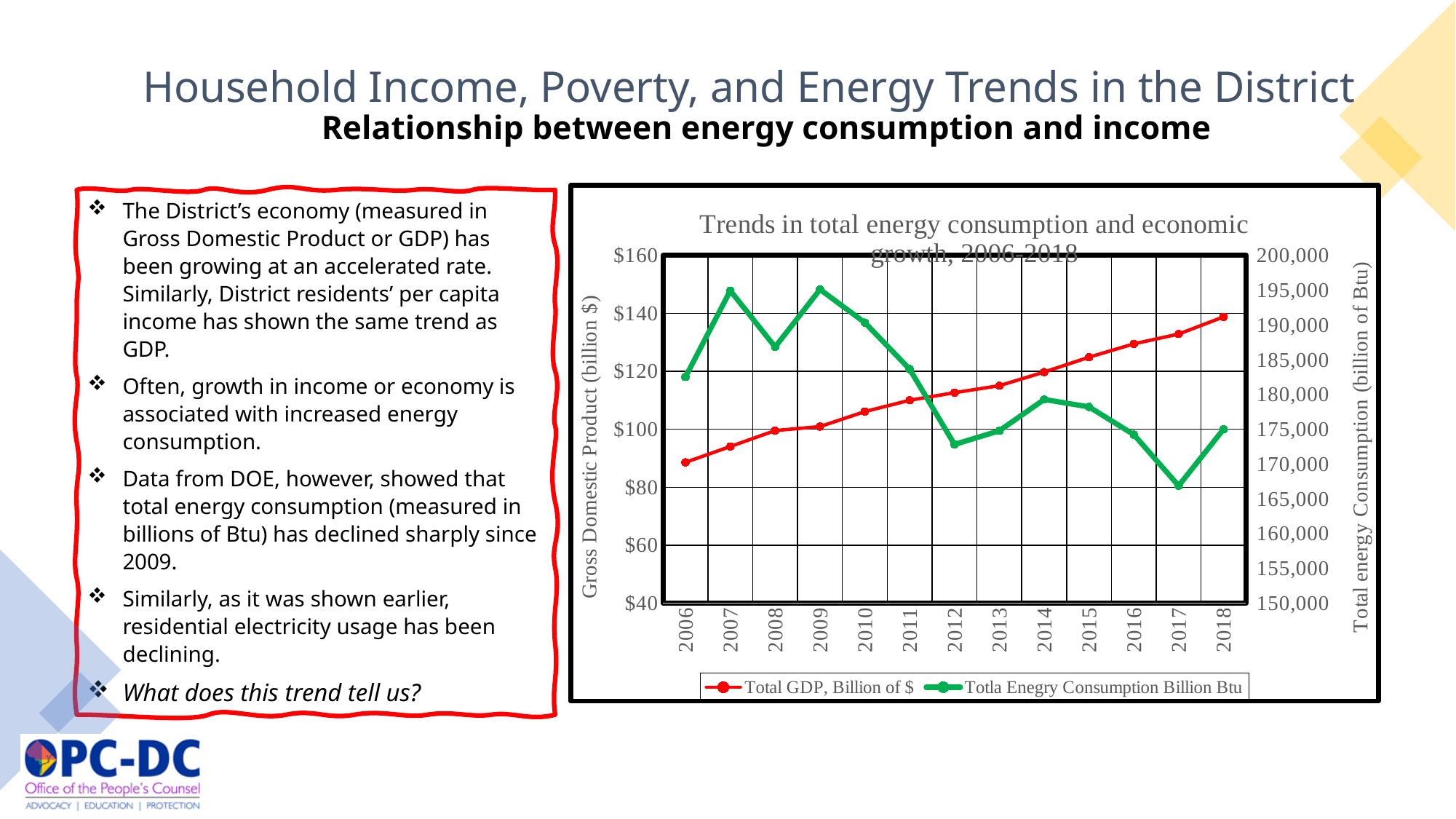
In which year is Total GDP highest? 2018 Does the Total GDP series rise or fall from 2006 to 2018? Rises In which year is Total GDP lowest? 2006 What is the label of the right-hand vertical axis of the chart? Total energy Consumption (billion of Btu) In which year is Total Energy Consumption lowest? 2017 How many series does the chart's legend list? 2 How many years are plotted along the x axis of the chart? 13 Is the Total GDP value for 2018 greater or less than $120? greater Which year has the larger Total Energy Consumption, 2009 or 2012? 2009 Is the Total GDP value for 2006 greater or less than $100? less What kind of chart is shown on the slide? Line chart Is the Total Energy Consumption value for 2017 greater or less than 170,000? less